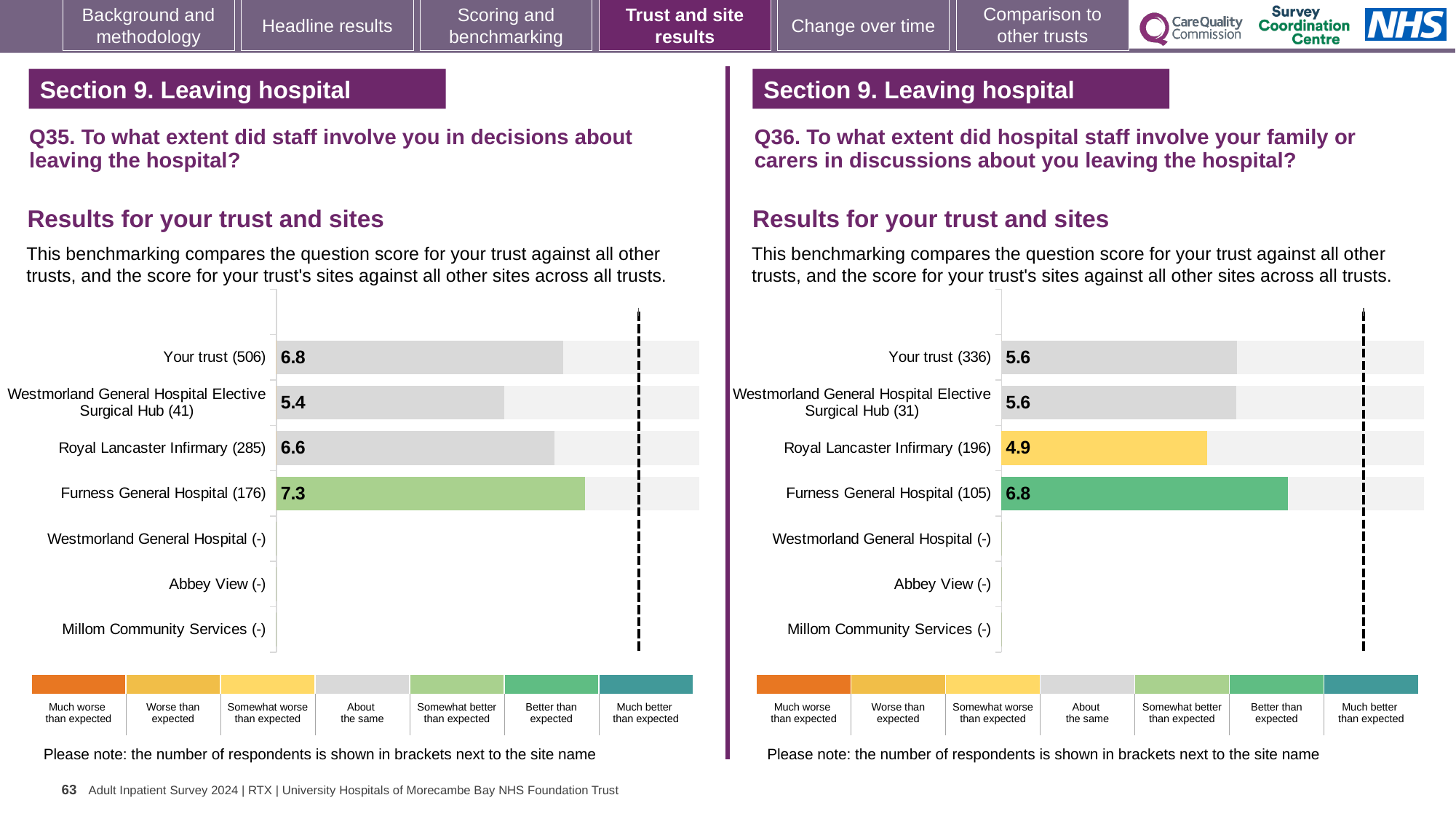
What kind of chart is used for the Q35 results on the left? Bar chart In the Q35 chart on the left, how many respondents are shown for Royal Lancaster Infirmary? 285 In the Q36 chart on the right, which benchmark category does the colour of the Furness General Hospital bar correspond to in the legend? Better than expected In the Q35 chart on the left, what is the score for Furness General Hospital? 7.3 In the Q36 chart on the right, what is the difference between the scores for Furness General Hospital and Westmorland General Hospital Elective Surgical Hub? 1.2 How many site/trust categories are listed on the y axis of the Q36 chart on the right? 7 In the Q35 chart on the left, which site has the lowest score? Westmorland General Hospital Elective Surgical Hub In the Q35 chart on the left, what is the score for Your trust? 6.8 In the Q36 chart on the right, what is the score for Royal Lancaster Infirmary? 4.9 In the Q35 chart on the left, what is the difference between the scores for Furness General Hospital and Royal Lancaster Infirmary? 0.7 In the Q36 chart on the right, which site has the highest score? Furness General Hospital In the Q36 chart on the right, which is larger: the score for Your trust or the score for Royal Lancaster Infirmary? Your trust